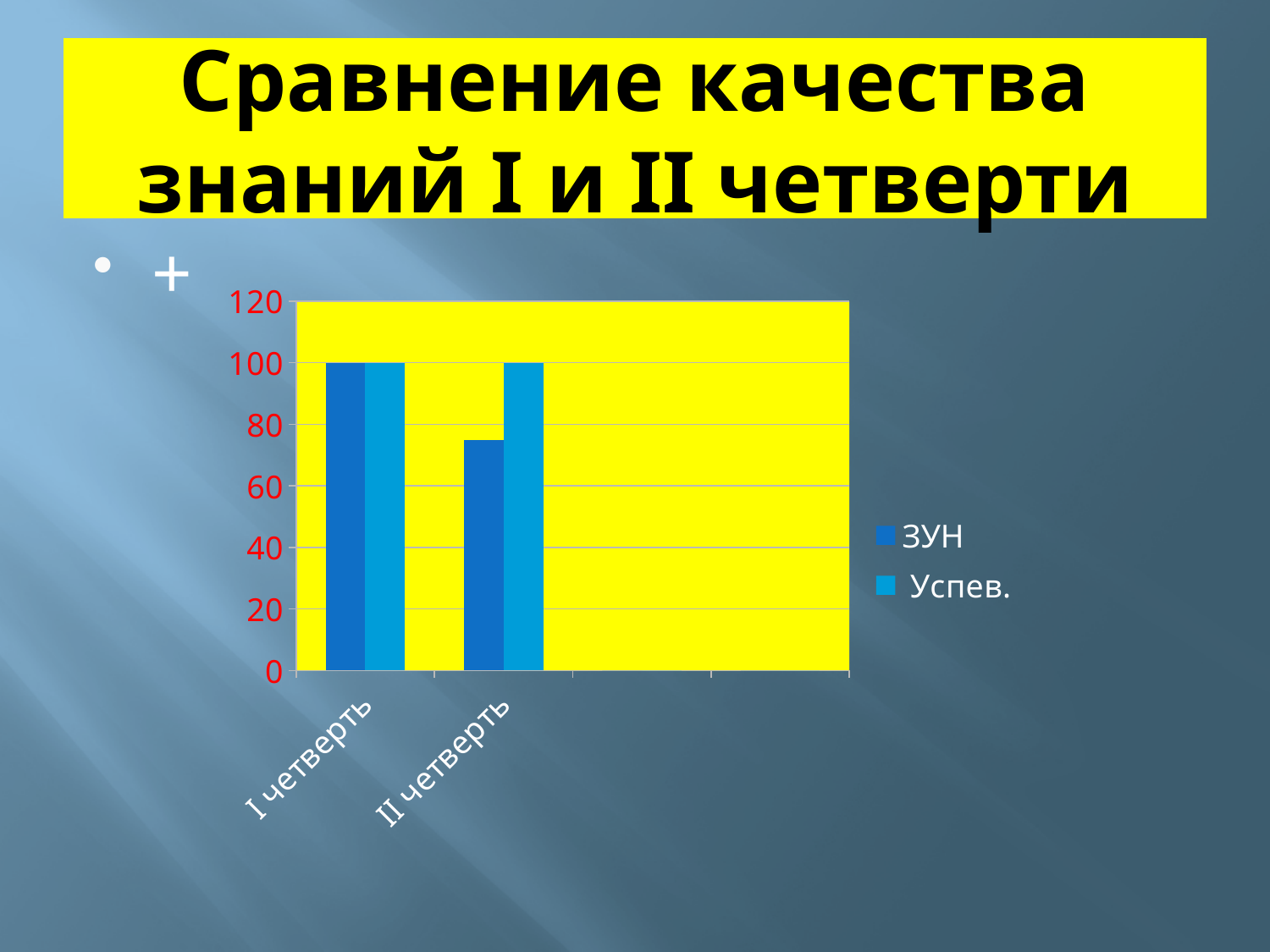
How many categories are shown on the x axis? 2 Which category has the lowest ЗУН value? II четверть What are the two entries listed in the legend? ЗУН and Успев. Is the value of ЗУН for II четверть greater or less than 80? less What is the value of Успев. for II четверть? 100 Is the value of ЗУН for II четверть greater or less than 60? greater What is the value of Успев. for I четверть? 100 Does the ЗУН value rise or fall from I четверть to II четверть? fall How many series does the legend list? 2 Which category has the higher ЗУН value, I четверть or II четверть? I четверть What kind of chart is shown on the slide? bar chart What is the value of ЗУН for I четверть? 100